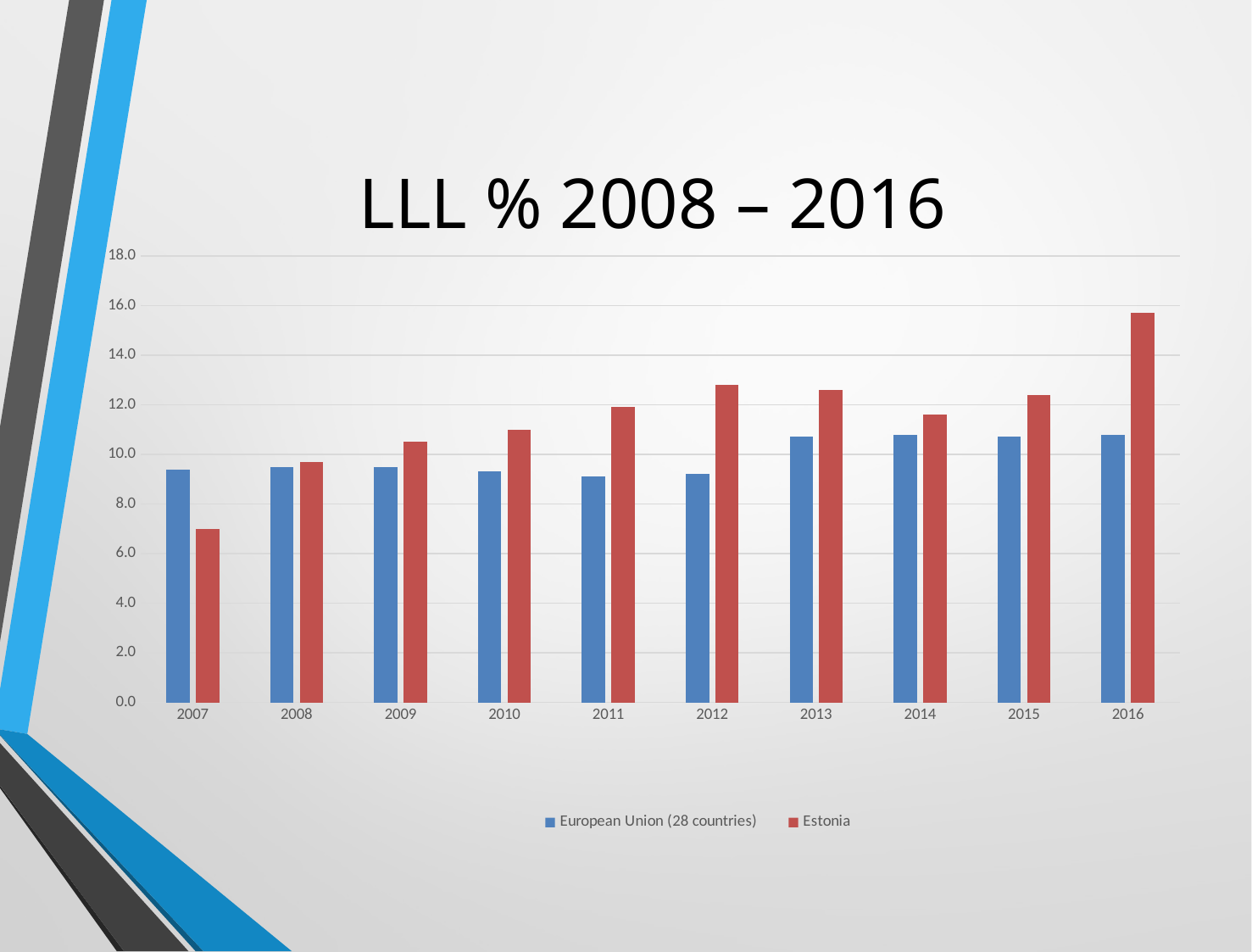
Do the values for Estonia generally rise or fall from 2007 to 2016? rise Which series has the larger value in 2016, European Union (28 countries) or Estonia? Estonia What is the title of the chart? LLL % 2008 – 2016 Which series has the larger value in 2007, European Union (28 countries) or Estonia? European Union (28 countries) In which year is the value for Estonia lowest? 2007 Is the value for European Union (28 countries) in 2011 greater or less than 10.0? less In which year is the value for Estonia highest? 2016 Is the value for Estonia in 2016 greater or less than 14.0? greater How many years are shown on the x axis? 10 Is the value for Estonia in 2007 greater or less than 8.0? less How many series does the legend list? 2 What kind of chart is shown on the slide? bar chart